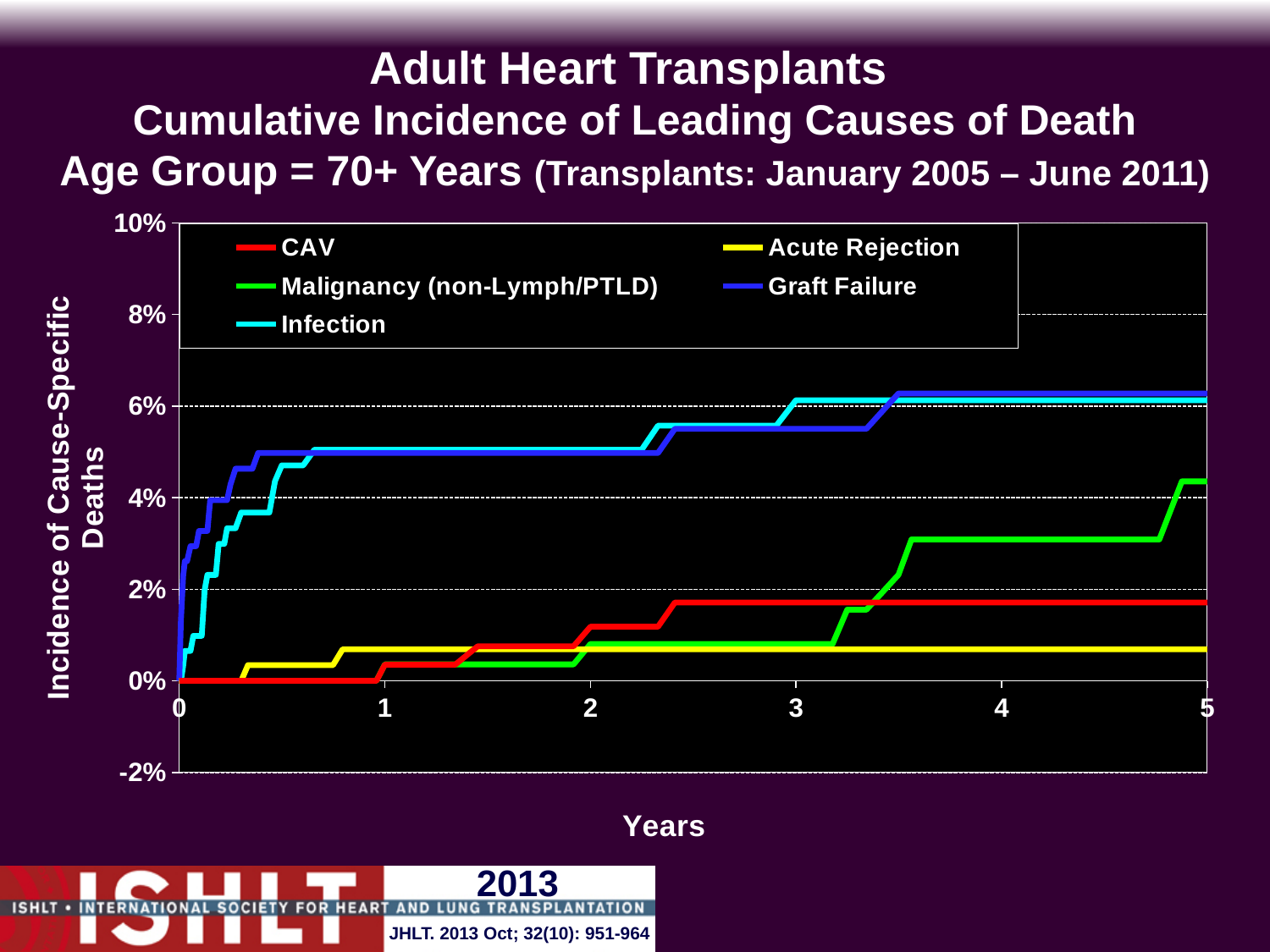
Which series has the lowest cumulative incidence at year 5? Acute Rejection At year 3, which is larger: Graft Failure or Malignancy (non-Lymph/PTLD)? Graft Failure What kind of chart is shown on the slide? line chart Which colour is used for the Infection series? cyan (light blue) Is the value for Graft Failure at year 1 greater or less than 4%? greater Is the value for Graft Failure at year 5 greater or less than 6%? greater Is the value for Malignancy (non-Lymph/PTLD) at year 4 greater or less than 4%? less How many series does the legend list? 5 Does the CAV line rise or fall as years increase? rise At year 5, which is larger: Malignancy (non-Lymph/PTLD) or CAV? Malignancy (non-Lymph/PTLD) What is the label of the x axis? Years